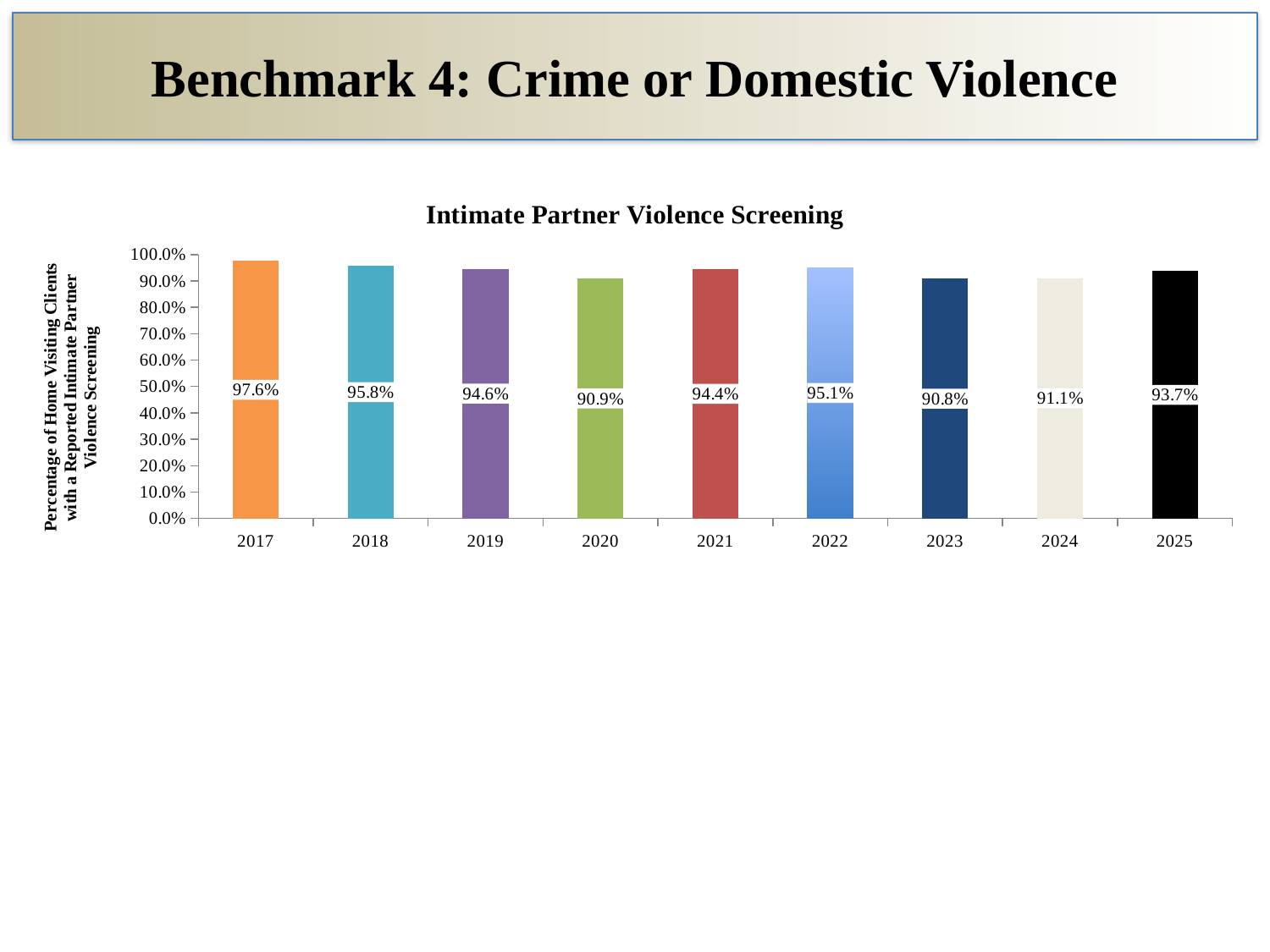
Do the values rise or fall from 2017 to 2020? fall Is the value for 2022 greater or less than 90.0%? greater Which year has the highest value? 2017 How many years are shown on the x axis? 9 Which year has the lowest value? 2023 Which is larger, the value for 2018 or the value for 2024? 2018 What kind of chart is this? bar chart What is the value for 2023? 90.8% What is the value for 2025? 93.7% What is the value for 2017? 97.6% What is the title of the chart? Intimate Partner Violence Screening What is the difference between the values for 2017 and 2020? 6.7%